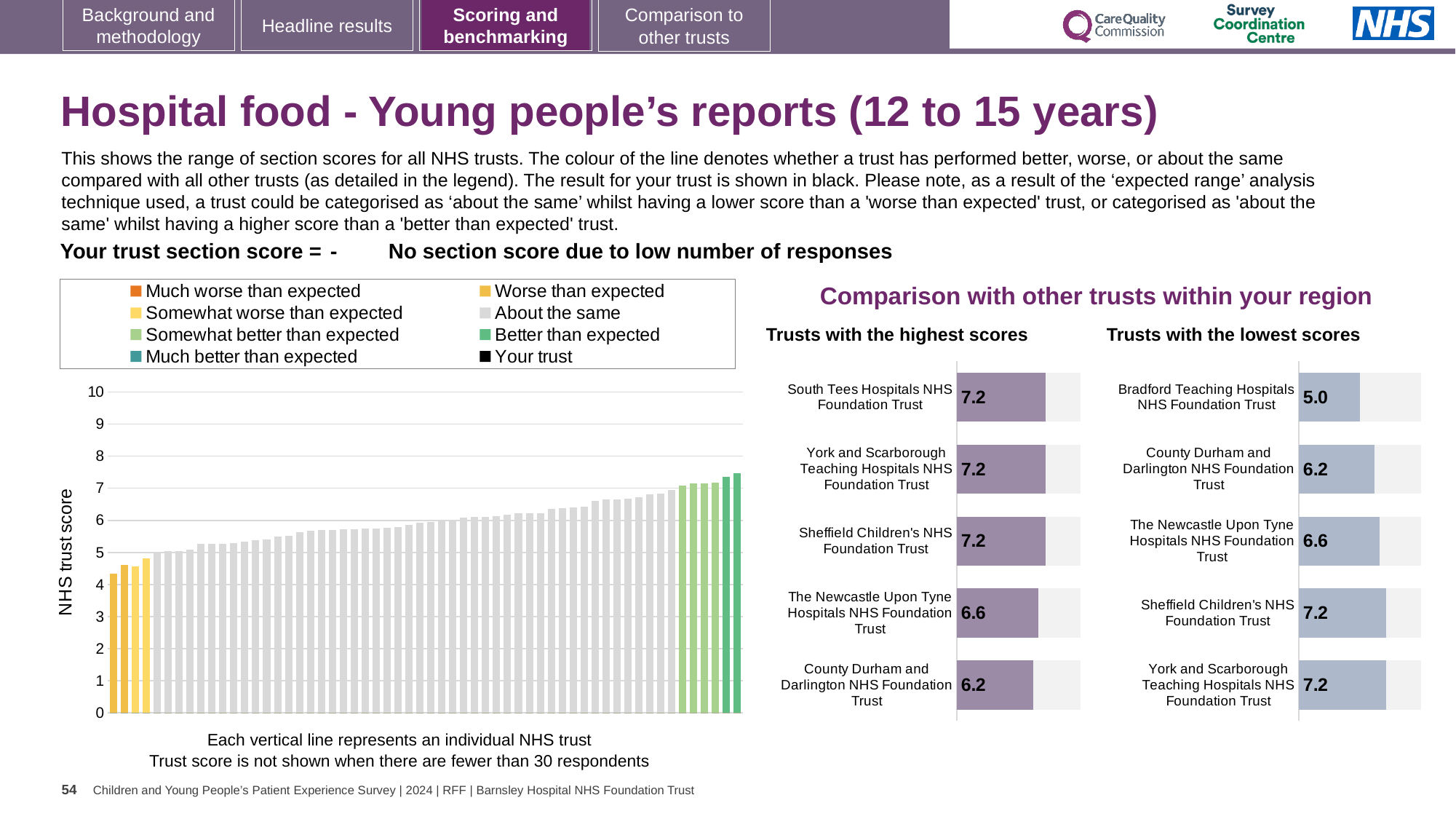
In the 'Trusts with the lowest scores' chart, which trust has the lowest score? Bradford Teaching Hospitals NHS Foundation Trust In the 'NHS trust score' chart on the left, do the bar values rise or fall from left to right? Rise What is the title of the vertical axis on the large chart on the left? NHS trust score What kind of chart is the large chart on the left with the 'NHS trust score' axis? Bar chart In the 'Trusts with the lowest scores' chart, what is the score for Bradford Teaching Hospitals NHS Foundation Trust? 5.0 In the 'NHS trust score' chart on the left, is the value of the leftmost bar greater or less than 5? less In the 'Trusts with the lowest scores' chart, what is the score for The Newcastle Upon Tyne Hospitals NHS Foundation Trust? 6.6 In the 'Trusts with the highest scores' chart, what is the score for South Tees Hospitals NHS Foundation Trust? 7.2 In the 'Trusts with the highest scores' chart, what is the difference between the scores of South Tees Hospitals NHS Foundation Trust and County Durham and Darlington NHS Foundation Trust? 1.0 How many trusts are listed in the 'Trusts with the highest scores' chart? 5 In the 'Trusts with the highest scores' chart, which has the higher score: The Newcastle Upon Tyne Hospitals NHS Foundation Trust or County Durham and Darlington NHS Foundation Trust? The Newcastle Upon Tyne Hospitals NHS Foundation Trust How many entries does the legend above the 'NHS trust score' chart list? 8